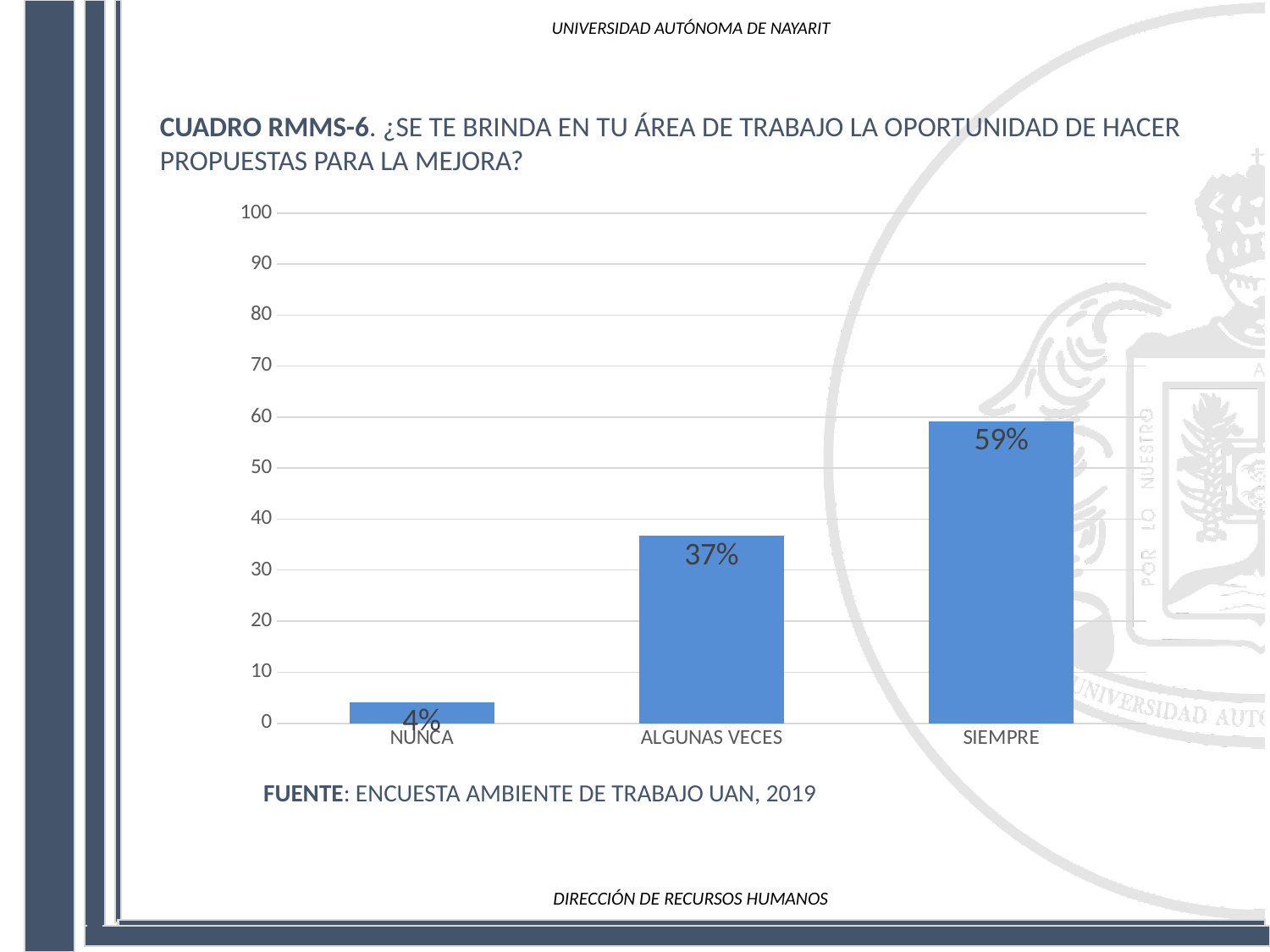
What is the difference between the values for ALGUNAS VECES and NUNCA? 33% Which category has the lowest value? NUNCA Which is larger, the value for ALGUNAS VECES or the value for NUNCA? ALGUNAS VECES What is the value for NUNCA? 4% What is the value for SIEMPRE? 59% How many categories are shown on the x axis? 3 What is the value for ALGUNAS VECES? 37% Which category has the highest value? SIEMPRE What is the difference between the values for SIEMPRE and ALGUNAS VECES? 22% What kind of chart is shown on the slide? bar chart Do the values rise or fall from NUNCA to SIEMPRE along the x axis? rise Is the value for SIEMPRE greater or less than 50? greater